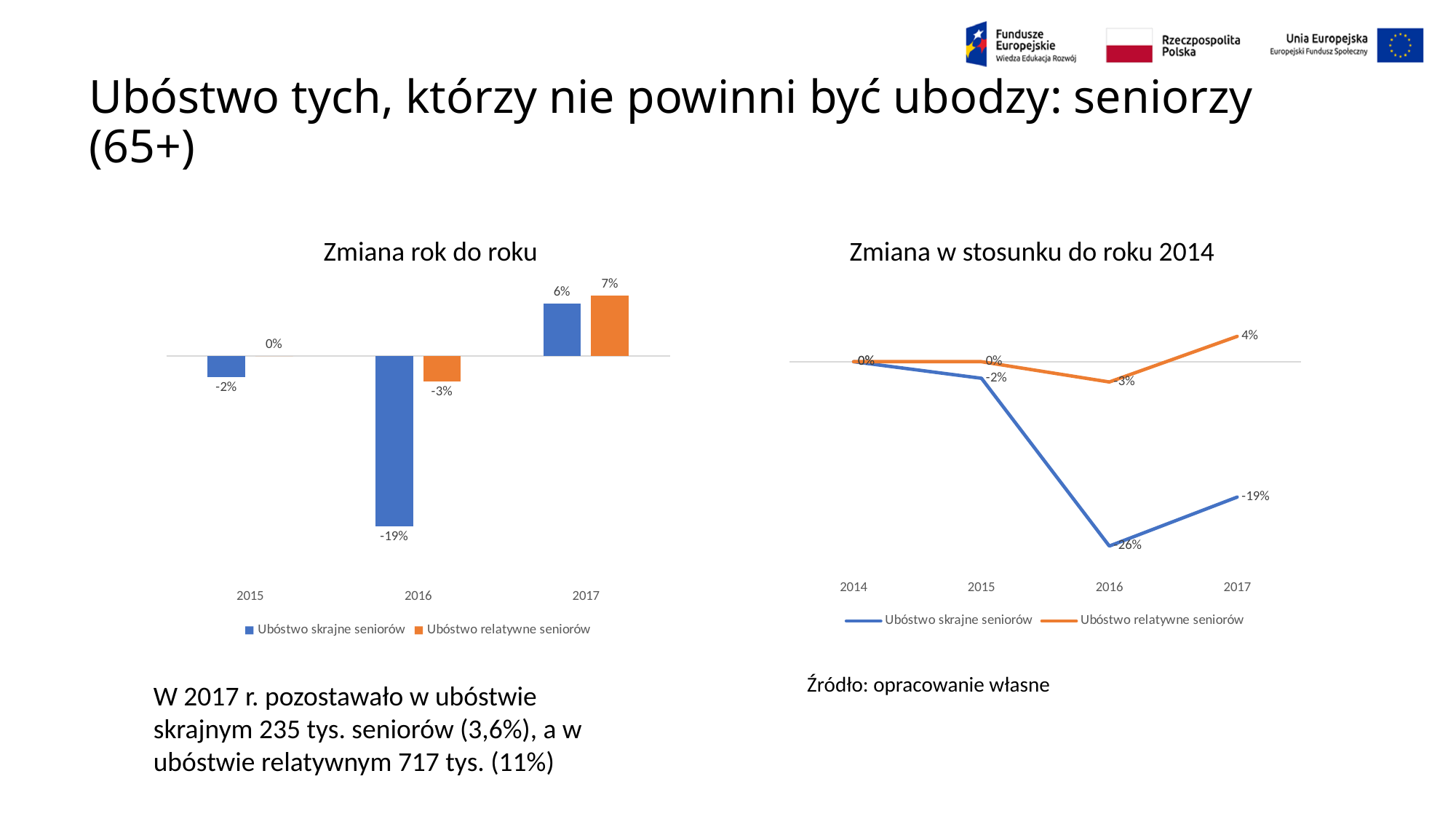
In the chart titled "Zmiana w stosunku do roku 2014", which series has the higher value in 2017? Ubóstwo relatywne seniorów What kind of chart is the one titled "Zmiana rok do roku"? Bar chart In the chart titled "Zmiana rok do roku", what is the value for Ubóstwo skrajne seniorów in 2016? -19% In the chart titled "Zmiana w stosunku do roku 2014", what is the value for Ubóstwo relatywne seniorów in 2017? 4% In the chart titled "Zmiana w stosunku do roku 2014", what is the value for Ubóstwo skrajne seniorów in 2016? -26% What kind of chart is the one titled "Zmiana w stosunku do roku 2014"? Line chart In the chart titled "Zmiana rok do roku", what is the difference between the 2017 values for Ubóstwo relatywne seniorów and Ubóstwo skrajne seniorów? 1 percentage point In the chart titled "Zmiana w stosunku do roku 2014", does the value for Ubóstwo skrajne seniorów rise or fall from 2016 to 2017? Rise In the chart titled "Zmiana w stosunku do roku 2014", how many series does the legend list? 2 In the chart titled "Zmiana rok do roku", what is the value for Ubóstwo relatywne seniorów in 2017? 7% In the chart titled "Zmiana rok do roku", how many years are shown on the x axis? 3 In the chart titled "Zmiana rok do roku", which year has the lowest value for Ubóstwo skrajne seniorów? 2016